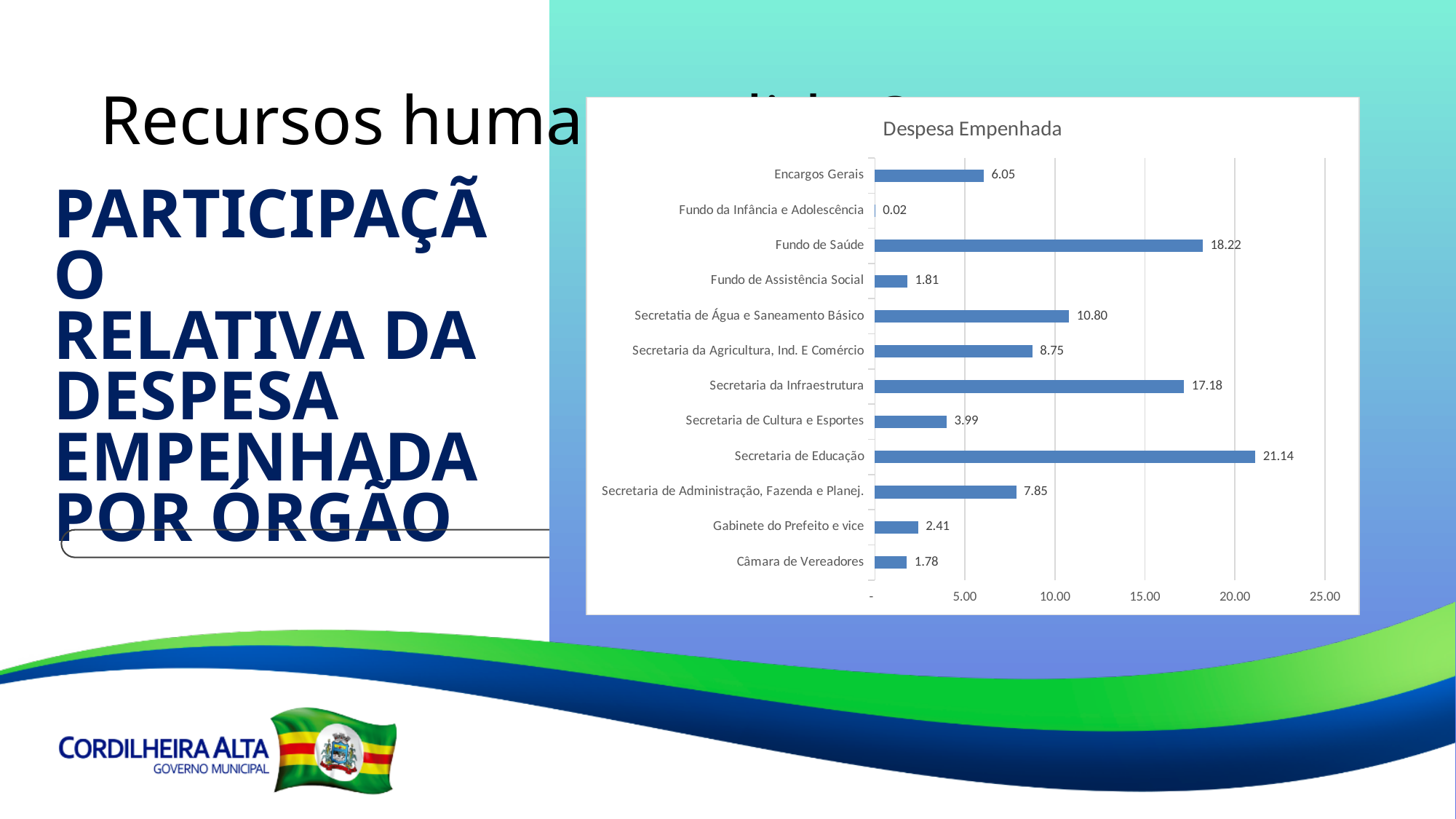
Which is larger, Secretatia de Água e Saneamento Básico or Secretaria da Agricultura, Ind. E Comércio? Secretatia de Água e Saneamento Básico How many categories are shown in the chart? 12 What is the value for Fundo de Saúde? 18.22 What is the difference between Secretaria de Educação and Fundo de Saúde? 2.92 What is the value for Secretaria da Infraestrutura? 17.18 Is the value for Encargos Gerais greater or less than 5.00? greater What is the difference between Câmara de Vereadores and Fundo de Assistência Social? 0.03 Which category has the lowest value? Fundo da Infância e Adolescência Which category has the highest value? Secretaria de Educação What is the value for Gabinete do Prefeito e vice? 2.41 What is the title of the chart? Despesa Empenhada What kind of chart is shown? bar chart